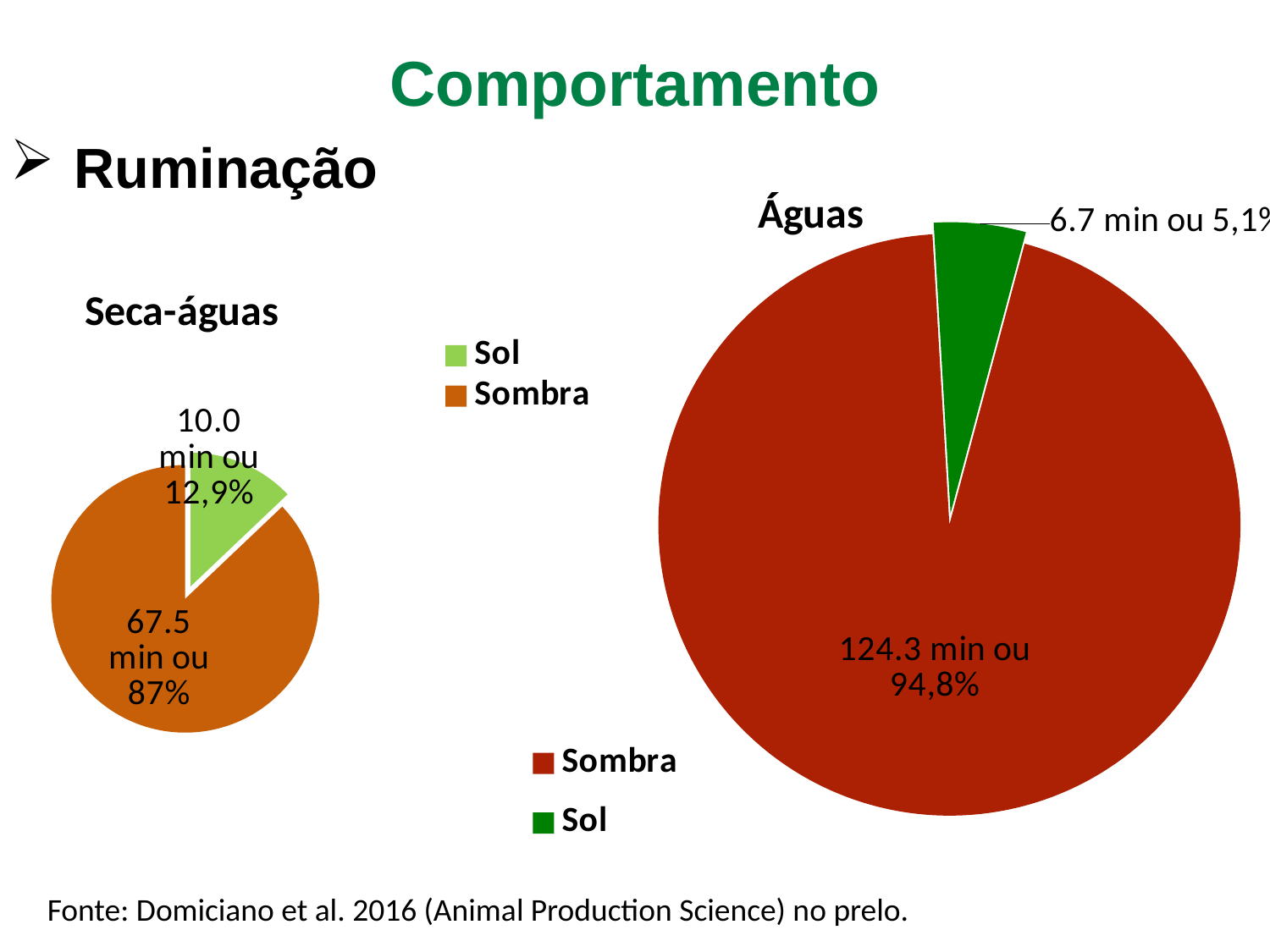
In the "Seca-águas" chart, what is the value for Sol? 10.0 min ou 12,9% How many slices does the "Águas" chart have? 2 In the "Seca-águas" chart, which slice is the largest? Sombra In the "Seca-águas" chart, what is the value for Sombra? 67.5 min ou 87% In the "Águas" chart, what is the value for Sombra? 124.3 min ou 94,8% In the "Águas" chart, what share of the pie does Sombra represent? 94,8% What colour is the Sol slice in the "Seca-águas" chart? light green What kind of chart is the "Seca-águas" chart? pie chart In the "Águas" chart, which slice is the smallest? Sol In the "Seca-águas" chart, what is the difference in minutes between Sombra and Sol? 57.5 min In the "Águas" chart, how many minutes are shown for Sol? 6.7 min In the "Seca-águas" chart, what share of the pie does Sol represent? 12,9%